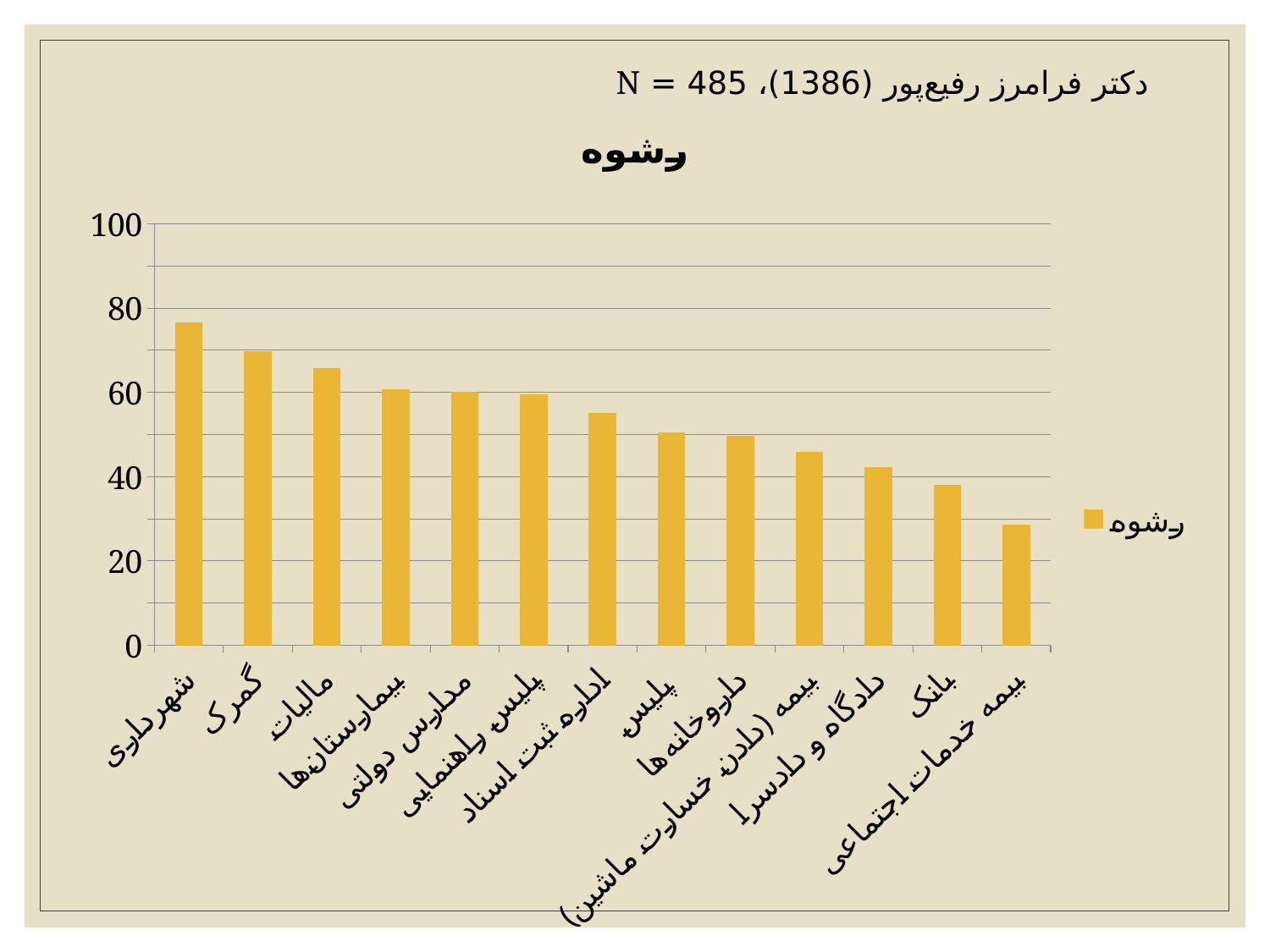
Which category has the lowest value? بیمه خدمات اجتماعی Which is larger, the value for دادگاه و دادسرا or the value for مالیات? مالیات What is the title of the chart? رشوه How many categories are plotted on the x axis? 13 Which is larger, the value for گمرک or the value for بانک? گمرک Is the value for بانک greater or less than 40? less Is the value for بیمه خدمات اجتماعی greater or less than 40? less Which category has the highest value? شهرداری How many series does the legend list? 1 Is the value for شهرداری greater or less than 60? greater What kind of chart is shown on the slide? bar chart Do the values rise or fall moving from left to right along the x axis? fall